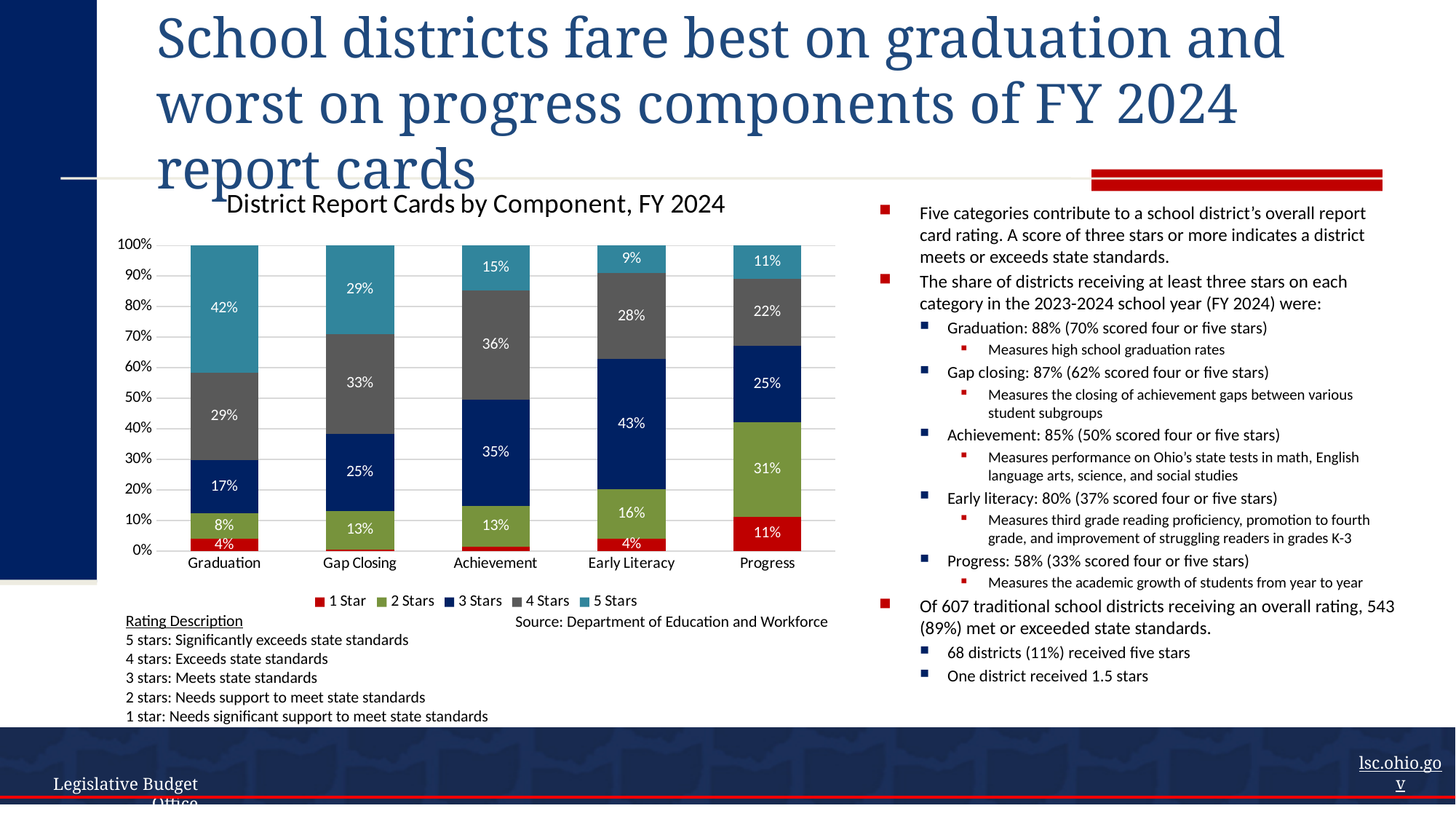
Which component has the highest 5 Stars share? Graduation What is the 1 Star share for Progress? 11% How many components (categories) are shown on the x axis of the chart? 5 Which component has the lowest 5 Stars share? Early Literacy How many series does the chart legend list? 5 What kind of chart is shown on the slide? stacked bar chart What is the title of the chart? District Report Cards by Component, FY 2024 What is the 4 Stars share for Achievement? 36% What is the 3 Stars share for Early Literacy? 43% What is the difference between the 2 Stars share for Progress and the 2 Stars share for Graduation? 23% Which is larger: the 3 Stars share for Gap Closing or the 3 Stars share for Achievement? Achievement What is the 5 Stars share for Graduation? 42%